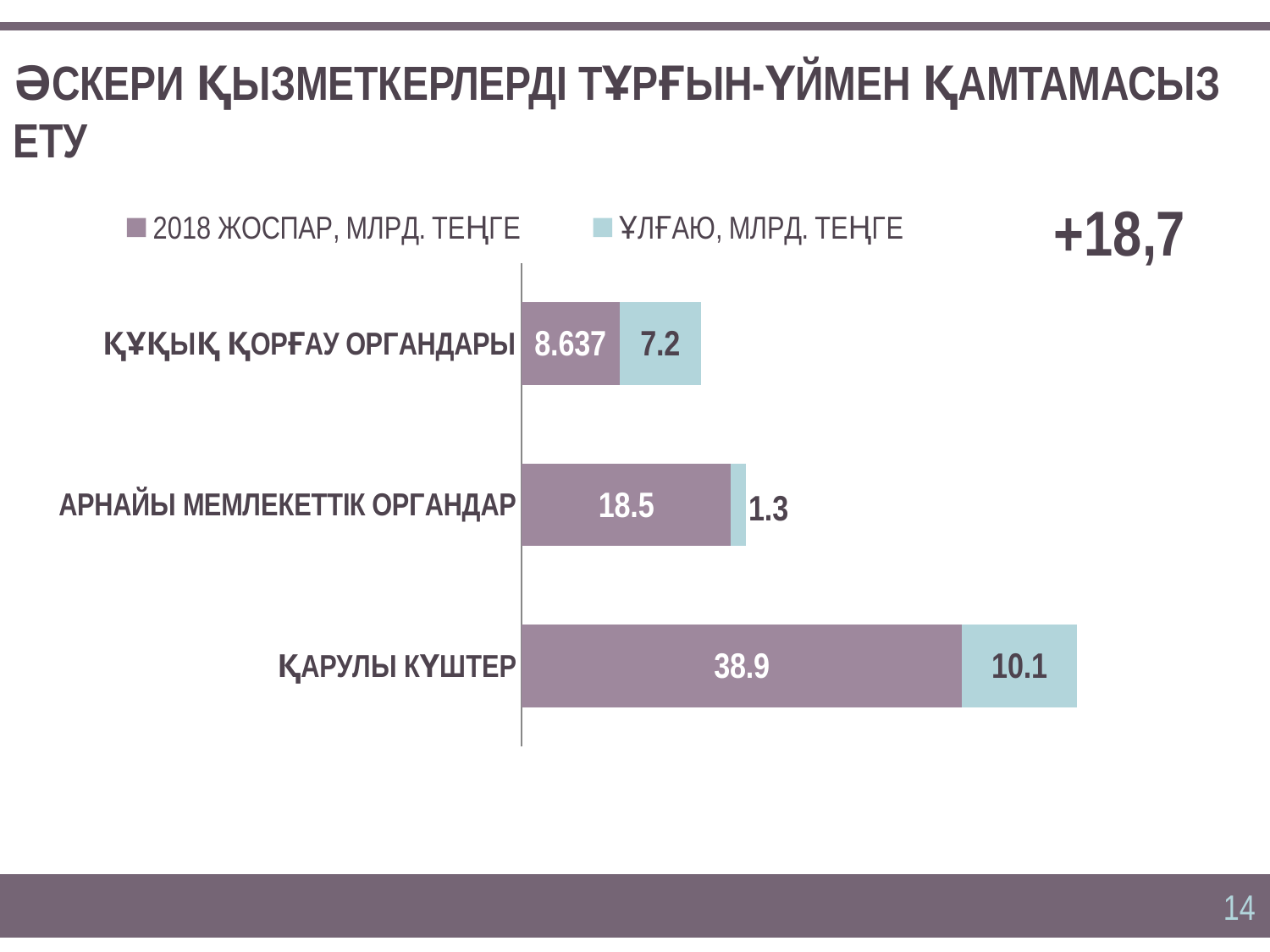
How many categories are shown in the chart? 3 What is the 2018 ЖОСПАР, МЛРД. ТЕҢГЕ value for ҚАРУЛЫ КҮШТЕР? 38.9 How many series does the legend list? 2 What is the total of the stacked bar for АРНАЙЫ МЕМЛЕКЕТТІК ОРГАНДАР? 19.8 What is the ҰЛҒАЮ, МЛРД. ТЕҢГЕ value for ҚҰҚЫҚ ҚОРҒАУ ОРГАНДАРЫ? 7.2 What is the difference between the 2018 ЖОСПАР values for ҚАРУЛЫ КҮШТЕР and АРНАЙЫ МЕМЛЕКЕТТІК ОРГАНДАР? 20.4 Which is larger: the ҰЛҒАЮ value for ҚАРУЛЫ КҮШТЕР or for ҚҰҚЫҚ ҚОРҒАУ ОРГАНДАРЫ? ҚАРУЛЫ КҮШТЕР Which category has the highest 2018 ЖОСПАР, МЛРД. ТЕҢГЕ value? ҚАРУЛЫ КҮШТЕР What is the total of the stacked bar for ҚАРУЛЫ КҮШТЕР? 49 Which category has the lowest ҰЛҒАЮ, МЛРД. ТЕҢГЕ value? АРНАЙЫ МЕМЛЕКЕТТІК ОРГАНДАР What kind of chart is shown on the slide? Stacked bar chart What is the 2018 ЖОСПАР, МЛРД. ТЕҢГЕ value for АРНАЙЫ МЕМЛЕКЕТТІК ОРГАНДАР? 18.5